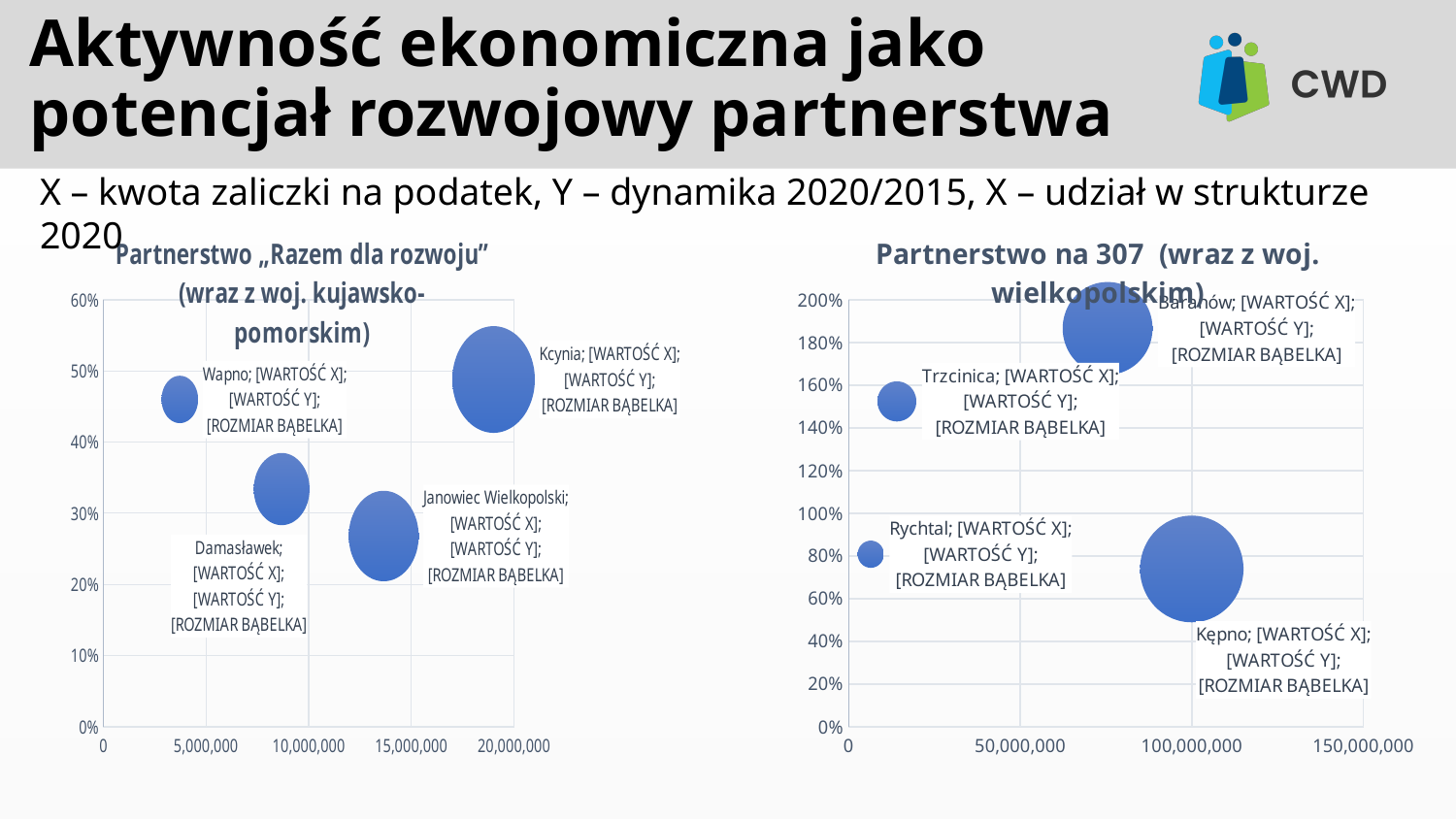
In the right chart, "Partnerstwo na 307", is the Y value for Trzcinica greater or less than 140%? greater In the right chart, "Partnerstwo na 307", which municipality has the highest Y value? Baranów In the left chart, "Partnerstwo „Razem dla rozwoju”", is the Y value for Janowiec Wielkopolski greater or less than 30%? less What is the title of the right chart? Partnerstwo na 307 (wraz z woj. wielkopolskim) What kind of chart is the left chart, "Partnerstwo „Razem dla rozwoju”"? bubble chart In the left chart, "Partnerstwo „Razem dla rozwoju”", how many bubbles (municipalities) are plotted? 4 In the right chart, "Partnerstwo na 307", how many bubbles (municipalities) are plotted? 4 In the right chart, "Partnerstwo na 307", which municipality has the largest X value? Kępno In the left chart, "Partnerstwo „Razem dla rozwoju”", is the X value for Kcynia greater or less than 15,000,000? greater In the left chart, "Partnerstwo „Razem dla rozwoju”", which has the larger X value, Kcynia or Damasławek? Kcynia